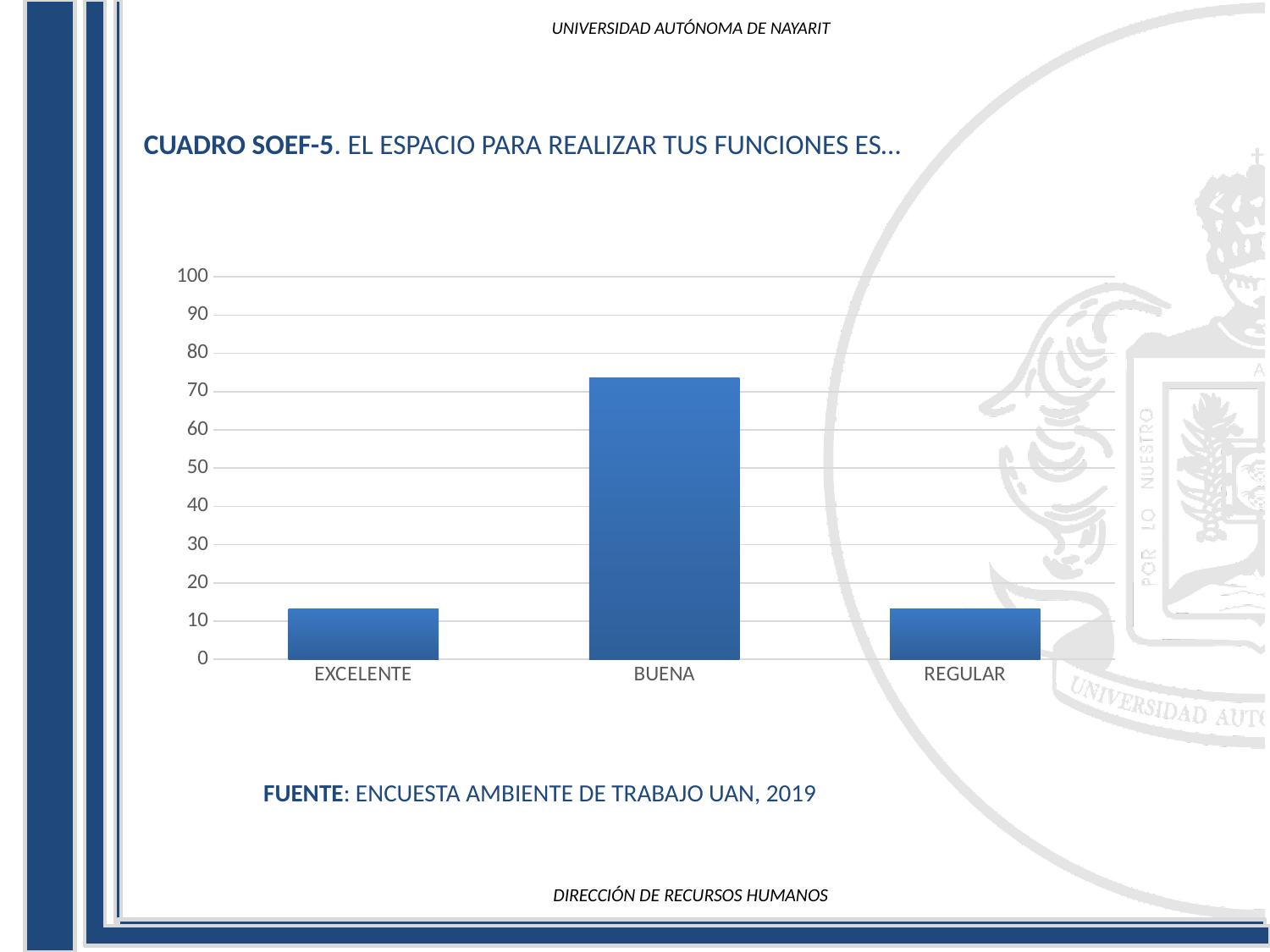
Is the value for BUENA greater or less than 70? greater How many categories are shown on the x axis of the chart? 3 Is the value for EXCELENTE greater or less than 20? less Which is larger, the value for BUENA or the value for EXCELENTE? BUENA Which is larger, the value for BUENA or the value for REGULAR? BUENA Is the value for BUENA greater or less than 80? less Which category has the highest value in the chart? BUENA What source is cited below the chart? ENCUESTA AMBIENTE DE TRABAJO UAN, 2019 What is the title of the chart on the slide? CUADRO SOEF-5. EL ESPACIO PARA REALIZAR TUS FUNCIONES ES… What kind of chart is shown on the slide? bar chart